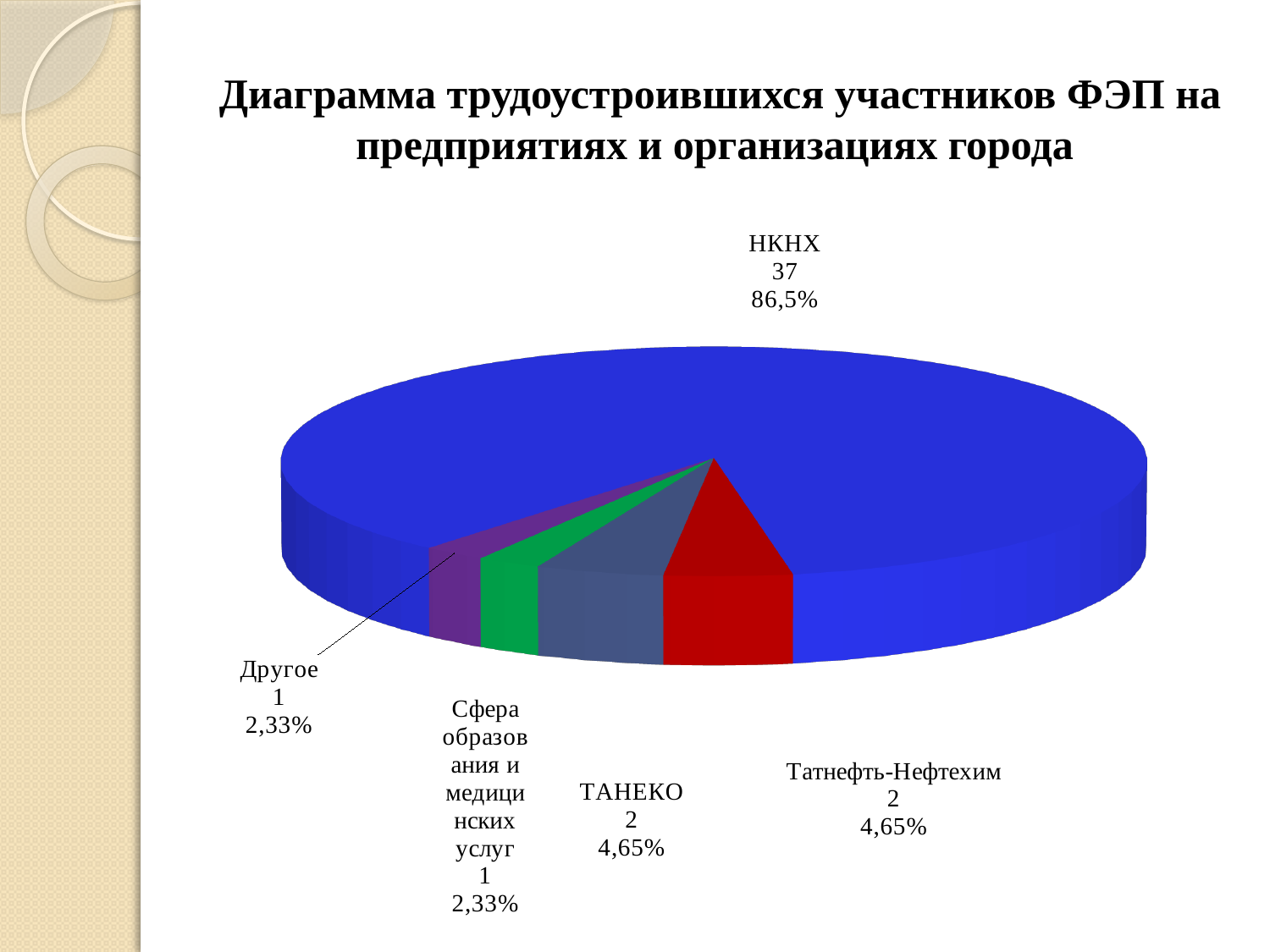
What share of the pie does Татнефть-Нефтехим represent? 4,65% What is the value for Другое? 1 What is the value for НКНХ? 37 What share of the pie does НКНХ represent? 86,5% What is the title of the chart? Диаграмма трудоустроившихся участников ФЭП на предприятиях и организациях города What share of the pie does Сфера образования и медицинских услуг represent? 2,33% Which category has the largest slice? НКНХ What is the difference between the values for НКНХ and ТАНЕКО? 35 What is the value for ТАНЕКО? 2 How many slices does the pie chart have? 5 Which is larger, the value for Татнефть-Нефтехим or the value for Другое? Татнефть-Нефтехим What kind of chart is shown on the slide? pie chart